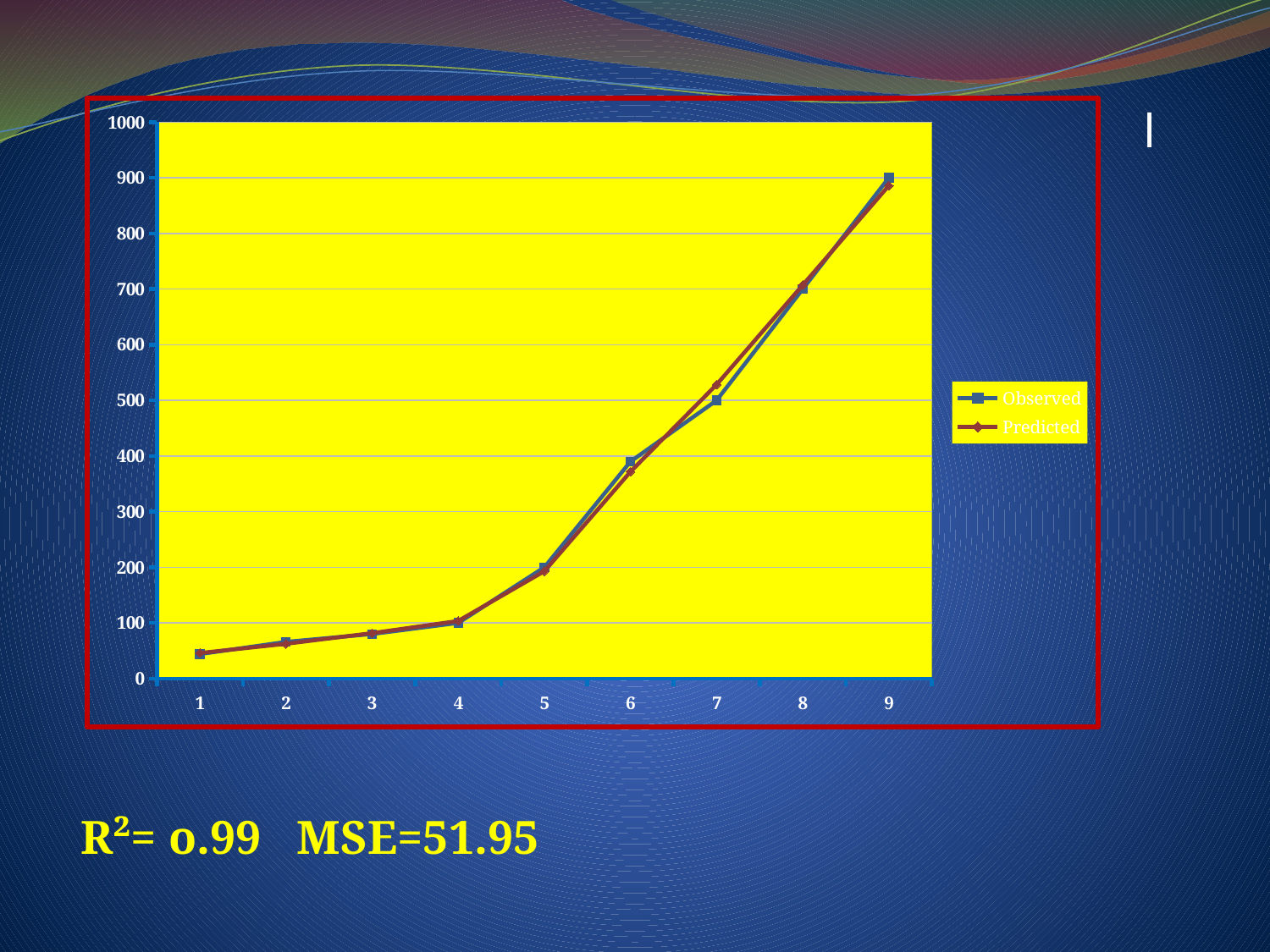
Is the Predicted value at x = 7 greater or less than 500? greater What kind of chart is shown on the slide? line chart Is the Observed value at x = 9 greater or less than 800? greater At which x value is the Predicted series lowest? 1 Do the Observed values rise or fall as the x axis goes from 1 to 9? rise How many series does the legend list? 2 At x = 7, which series has the higher value, Observed or Predicted? Predicted What are the two series named in the legend? Observed and Predicted Is the Predicted value at x = 1 greater or less than 100? less At which x value is the Observed series highest? 9 How many points are plotted along the x axis for each series? 9